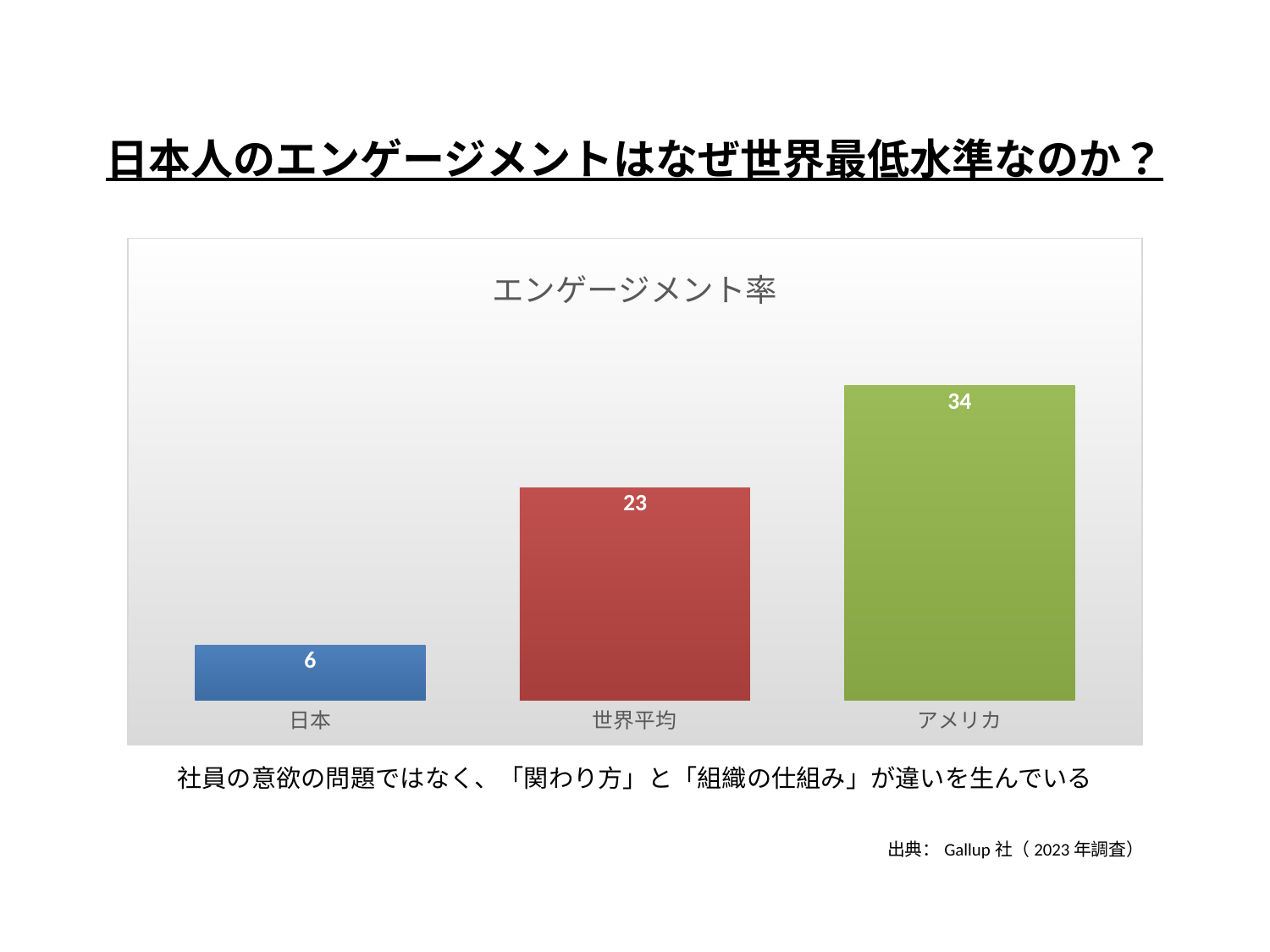
Which category has the highest value in the エンゲージメント率 chart? アメリカ What is the value for 日本 in the エンゲージメント率 chart? 6 What is the value for アメリカ in the エンゲージメント率 chart? 34 Which category has the lowest value in the エンゲージメント率 chart? 日本 What is the title of the chart on the slide? エンゲージメント率 Do the values rise or fall from left to right across the categories? Rise What is the difference between the values for 世界平均 and 日本? 17 How many categories are shown in the エンゲージメント率 chart? 3 What is the value for 世界平均 in the エンゲージメント率 chart? 23 What is the difference between the values for アメリカ and 日本? 28 What kind of chart is shown on the slide? Bar chart Which is larger, the value for 世界平均 or the value for アメリカ? アメリカ